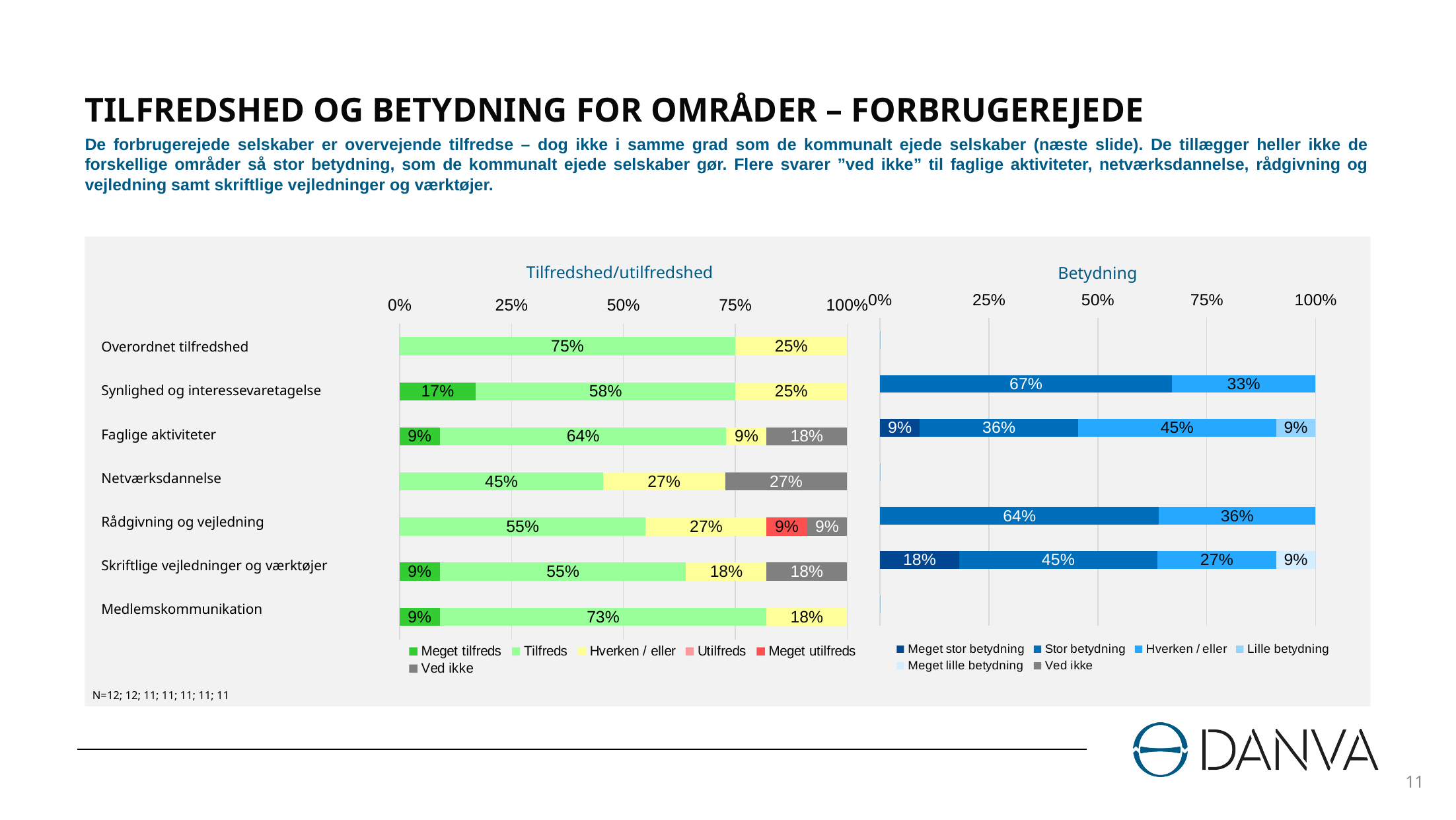
In the Betydning chart, which is larger: the Stor betydning value for Rådgivning og vejledning or for Skriftlige vejledninger og værktøjer? Rådgivning og vejledning In the Betydning chart, what is the Hverken / eller value for Faglige aktiviteter? 45% What kind of chart is the Tilfredshed/utilfredshed chart? Stacked bar chart In the Tilfredshed/utilfredshed chart, what is the difference between the Tilfreds values for Medlemskommunikation and Rådgivning og vejledning? 18% How many series does the legend of the Betydning chart list? 6 In the Tilfredshed/utilfredshed chart, what is the Tilfreds value for Overordnet tilfredshed? 75% How many categories are shown on the y axis of the Tilfredshed/utilfredshed chart? 7 In the Betydning chart, what is the Stor betydning value for Synlighed og interessevaretagelse? 67% In the Tilfredshed/utilfredshed chart, what is the Ved ikke value for Netværksdannelse? 27% In the Tilfredshed/utilfredshed chart, which category has the lowest Tilfreds value? Netværksdannelse In the Tilfredshed/utilfredshed chart, which category has the highest Tilfreds value? Overordnet tilfredshed In the Tilfredshed/utilfredshed chart, what is the Meget tilfreds value for Synlighed og interessevaretagelse? 17%